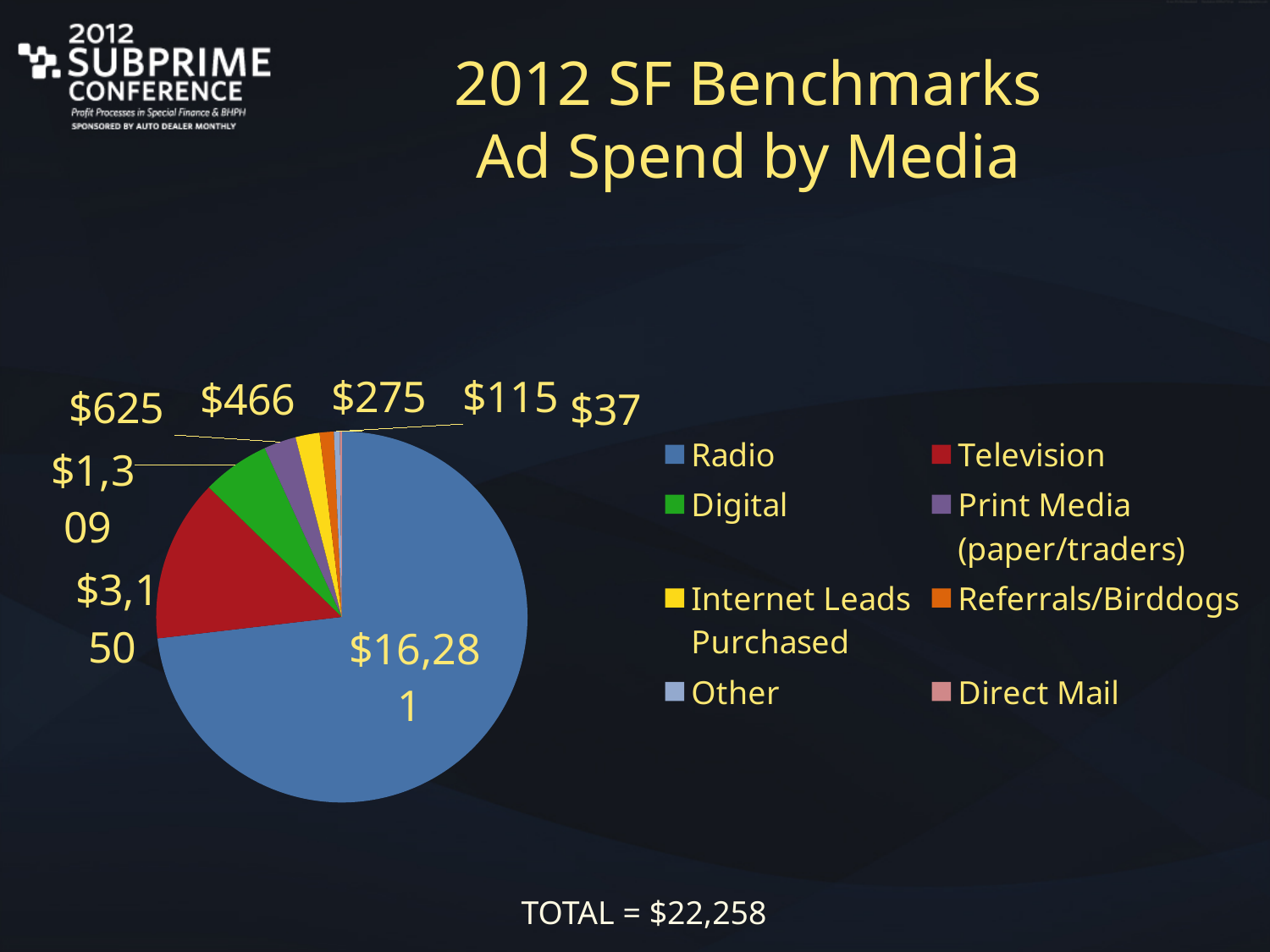
Which media category has the highest ad spend? Radio What is the ad spend value for Radio? $16,281 Which has a larger ad spend, Print Media (paper/traders) or Referrals/Birddogs? Print Media (paper/traders) What is the ad spend value for Direct Mail? $37 What is the ad spend value for Internet Leads Purchased? $466 How many media categories does the legend list? 8 What type of chart is shown on the slide? Pie chart What is the ad spend value for Television? $3,150 What is the difference between the Television and Digital ad spend values? $1,841 Which media category has the lowest ad spend? Direct Mail What total ad spend is stated below the chart? $22,258 What is the ad spend value for Digital? $1,309